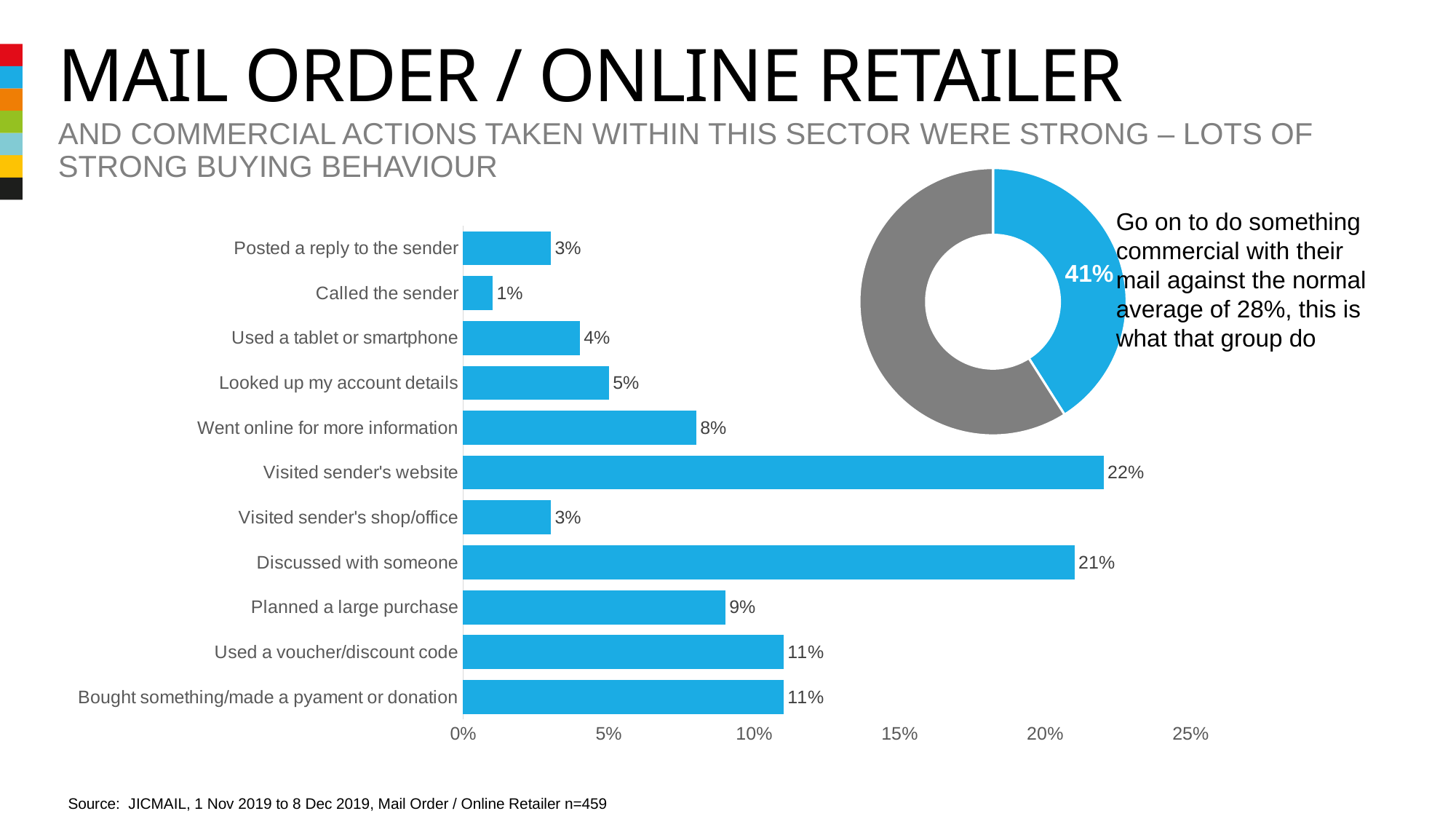
What is the highest value shown on the x axis of the bar chart? 25% How many categories does the bar chart show? 11 In the bar chart, which is larger: 'Went online for more information' or 'Looked up my account details'? Went online for more information In the bar chart, what is the value for 'Called the sender'? 1% In the bar chart, which category has the lowest value? Called the sender In the bar chart, what is the value for 'Visited sender's website'? 22% In the bar chart, what is the value for 'Planned a large purchase'? 9% In the bar chart, what is the difference between 'Used a voucher/discount code' and 'Planned a large purchase'? 2% What kind of chart is the chart on the left of the slide? Bar chart In the doughnut chart, what percentage is shown for the blue segment? 41% In the bar chart, which category has the highest value? Visited sender's website In the bar chart, what is the difference between 'Visited sender's website' and 'Discussed with someone'? 1%